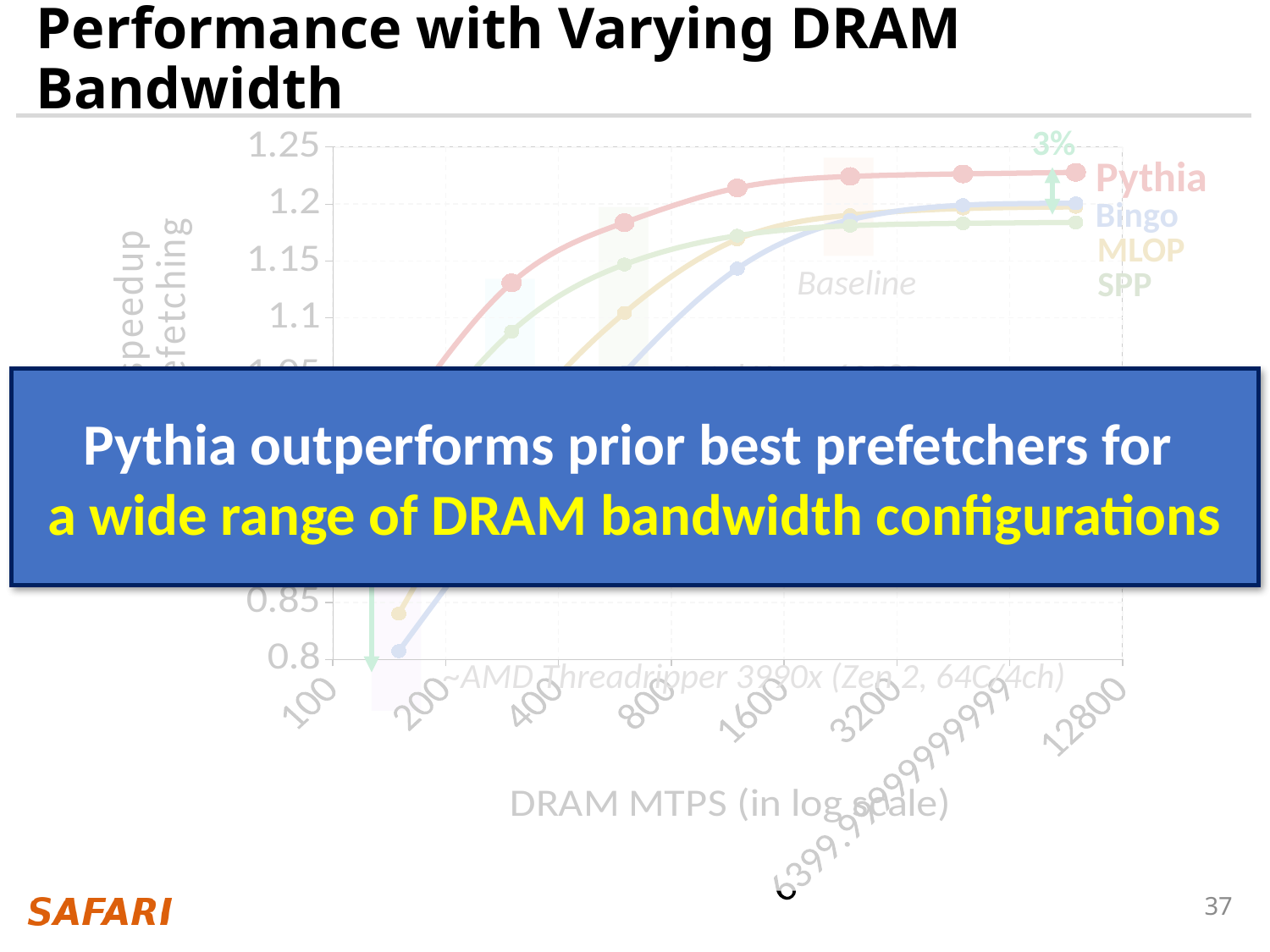
At 12800 DRAM MTPS, which is larger, the Pythia value or the SPP value? Pythia What is the title of the x axis? DRAM MTPS (in log scale) What kind of chart is shown on the slide? line chart Is the SPP value at 12800 DRAM MTPS greater or less than 1.2? less Is the Pythia value at 400 DRAM MTPS greater or less than 1.1? greater Which series has the highest speedup at 12800 DRAM MTPS? Pythia How many series does the chart's legend list? 4 Do the speedup values rise or fall as DRAM MTPS increases along the x axis? rise Is the Pythia value at 12800 DRAM MTPS greater or less than 1.2? greater At 400 DRAM MTPS, which is larger, the Pythia value or the SPP value? Pythia What percentage is annotated at the top right of the chart above the Pythia line? 3%